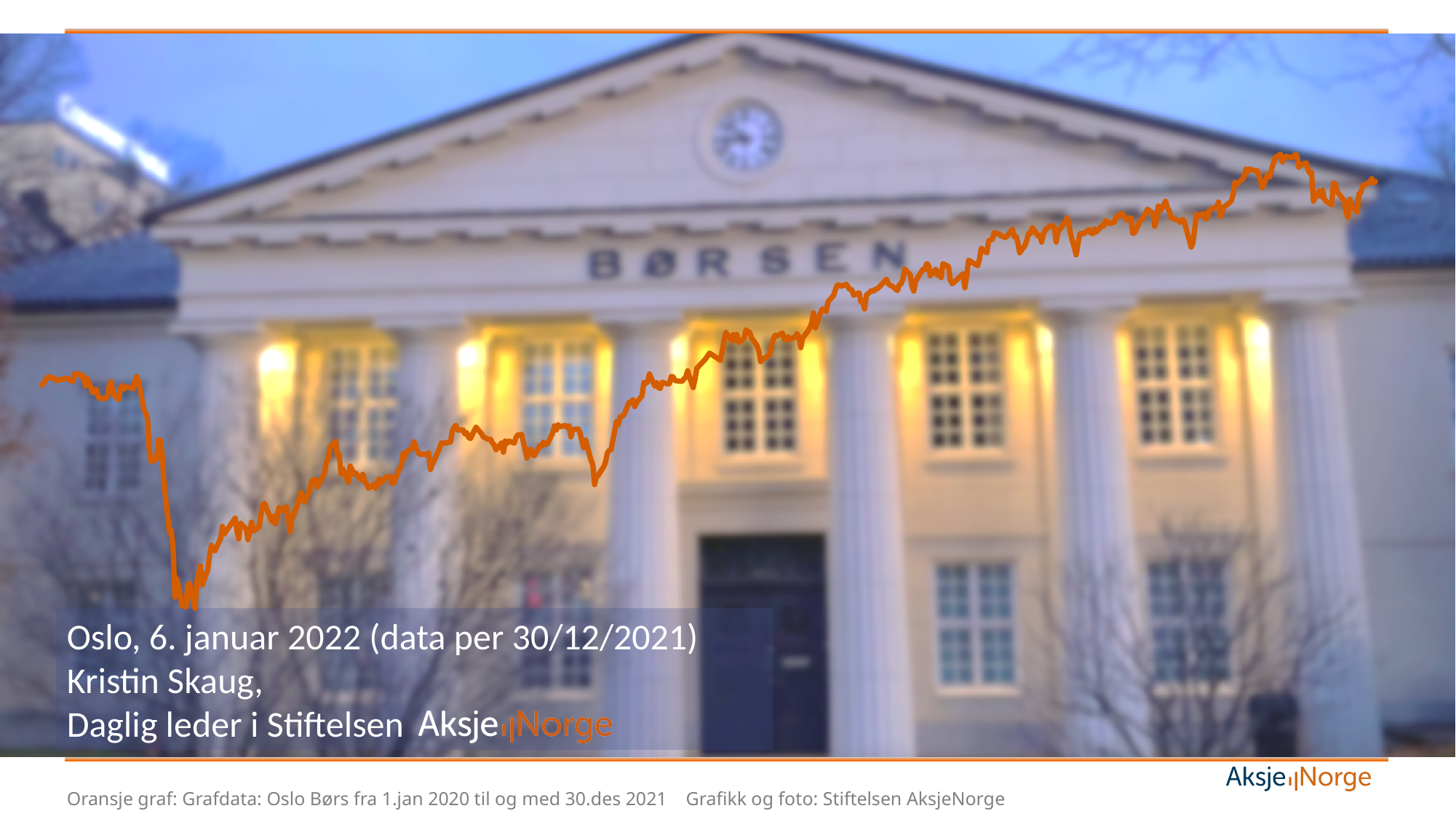
Near which part of the chart does the orange line reach its lowest point: the left, the middle, or the right? left According to the caption, what data does the orange graph show? Oslo Børs fra 1.jan 2020 til og med 30.des 2021 Near which part of the chart does the orange line reach its highest point: the left, the middle, or the right? right Is the orange line higher at its right end or at its left end? right end Overall, does the orange line rise or fall from the left side of the slide to the right side? rise How many lines (series) are plotted on the chart? 1 What kind of chart is drawn over the photo on the slide? line chart What colour is the line plotted on the chart? orange